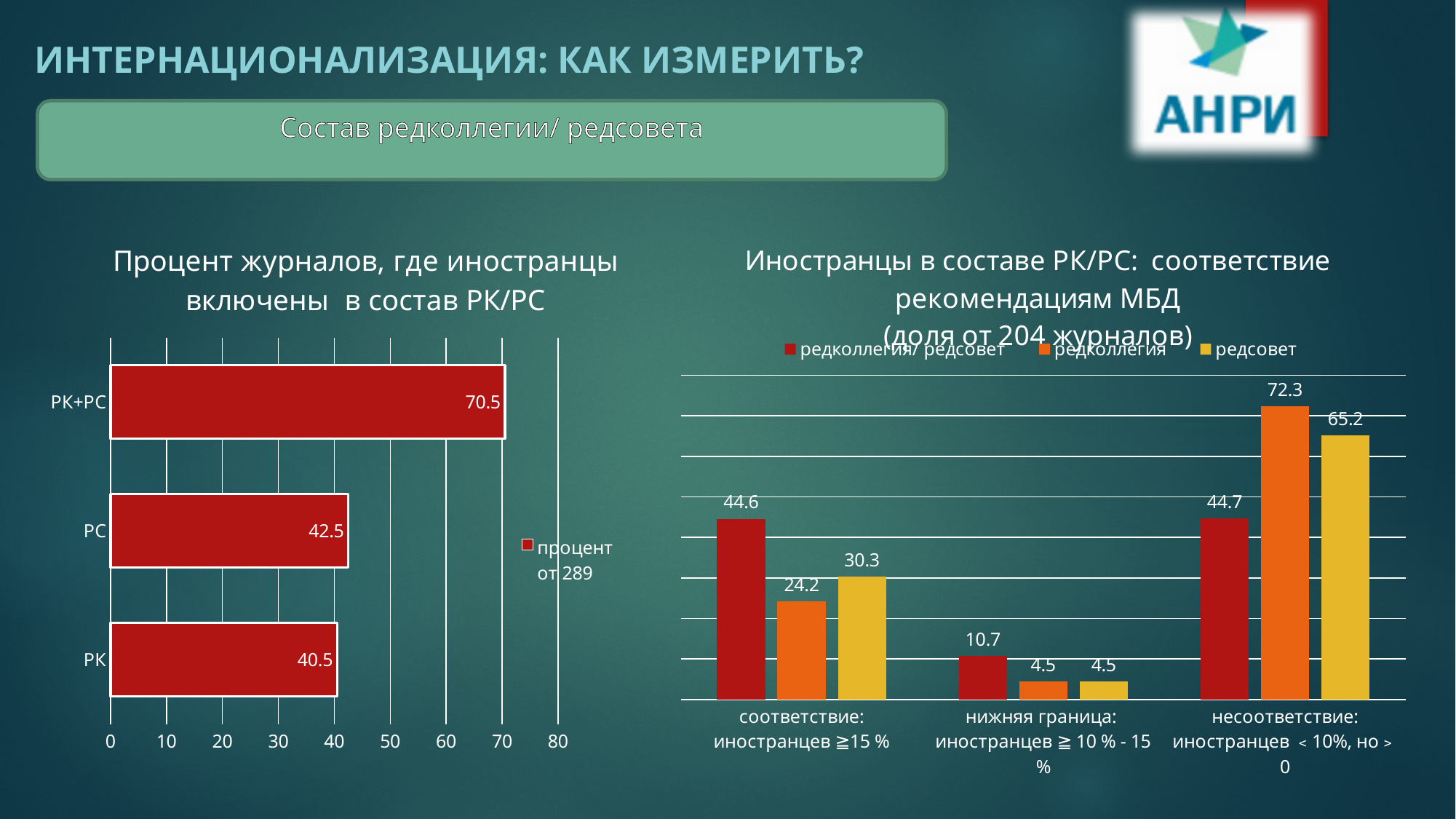
In the right chart 'Иностранцы в составе РК/РС', what is the difference between редколлегия and редсовет in the category 'несоответствие: иностранцев < 10%, но > 0'? 7.1 In the right chart 'Иностранцы в составе РК/РС', what is the value of редсовет for the category 'соответствие: иностранцев ≧15 %'? 30.3 In the right chart 'Иностранцы в составе РК/РС', what is the value of редколлегия for the category 'несоответствие: иностранцев < 10%, но > 0'? 72.3 In the left chart 'Процент журналов, где иностранцы включены в состав РК/РС', what is the value for РК+РС? 70.5 In the left chart 'Процент журналов, где иностранцы включены в состав РК/РС', what is the difference between the values for РК+РС and РС? 28 In the left chart 'Процент журналов, где иностранцы включены в состав РК/РС', how many categories are shown? 3 In the right chart 'Иностранцы в составе РК/РС', which series has the highest value in the category 'несоответствие: иностранцев < 10%, но > 0'? редколлегия In the left chart 'Процент журналов, где иностранцы включены в состав РК/РС', which category has the lowest value? РК In the right chart 'Иностранцы в составе РК/РС', how many series does the legend list? 3 What is the legend entry of the left chart 'Процент журналов, где иностранцы включены в состав РК/РС'? процент от 289 In the right chart 'Иностранцы в составе РК/РС', which is larger for the category 'соответствие: иностранцев ≧15 %': редколлегия or редсовет? редсовет What kind of chart is the left chart 'Процент журналов, где иностранцы включены в состав РК/РС'? bar chart